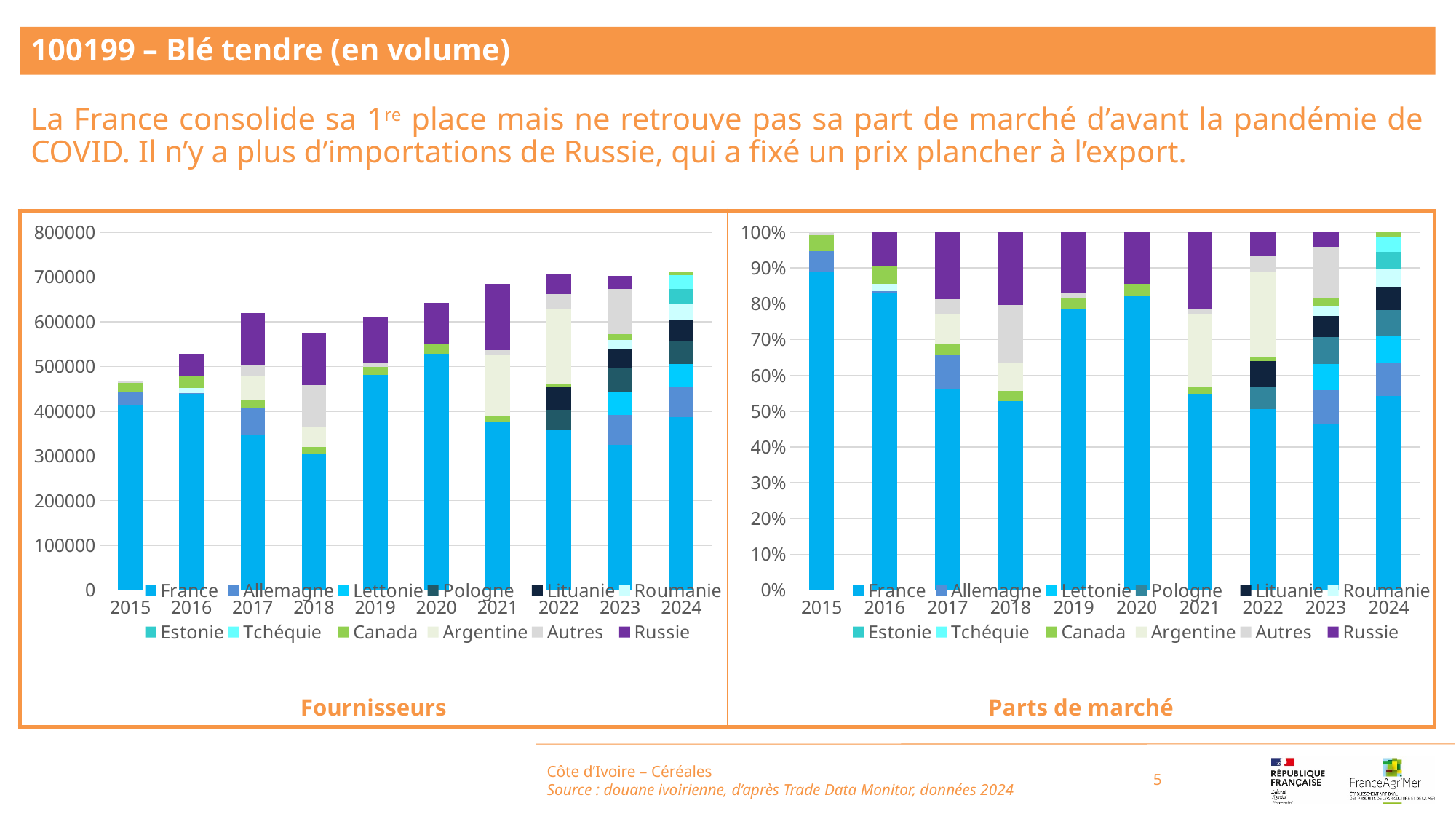
In the "Parts de marché" chart, is the share for France in 2024 greater or less than 50%? greater How many years are shown on the x axis of the "Parts de marché" chart? 10 In the "Parts de marché" chart, does the share for France generally rise or fall from 2015 to 2024? fall In the "Fournisseurs" chart, which year has the lowest total stacked bar? 2015 In the "Fournisseurs" chart, is the total stacked bar for 2018 greater or less than 600000? less What kind of chart is the "Fournisseurs" chart on the left? Stacked bar chart How many series does the legend of the "Fournisseurs" chart list? 12 Which series is shown in purple in the legend of the "Fournisseurs" chart? Russie In the "Fournisseurs" chart, which is larger: the value for France in 2019 or in 2021? 2019 In the "Fournisseurs" chart, which year has the highest value for France? 2020 In the "Fournisseurs" chart, is the value for France in 2020 greater or less than 500000? greater In the "Parts de marché" chart, which year has the highest share for France? 2015